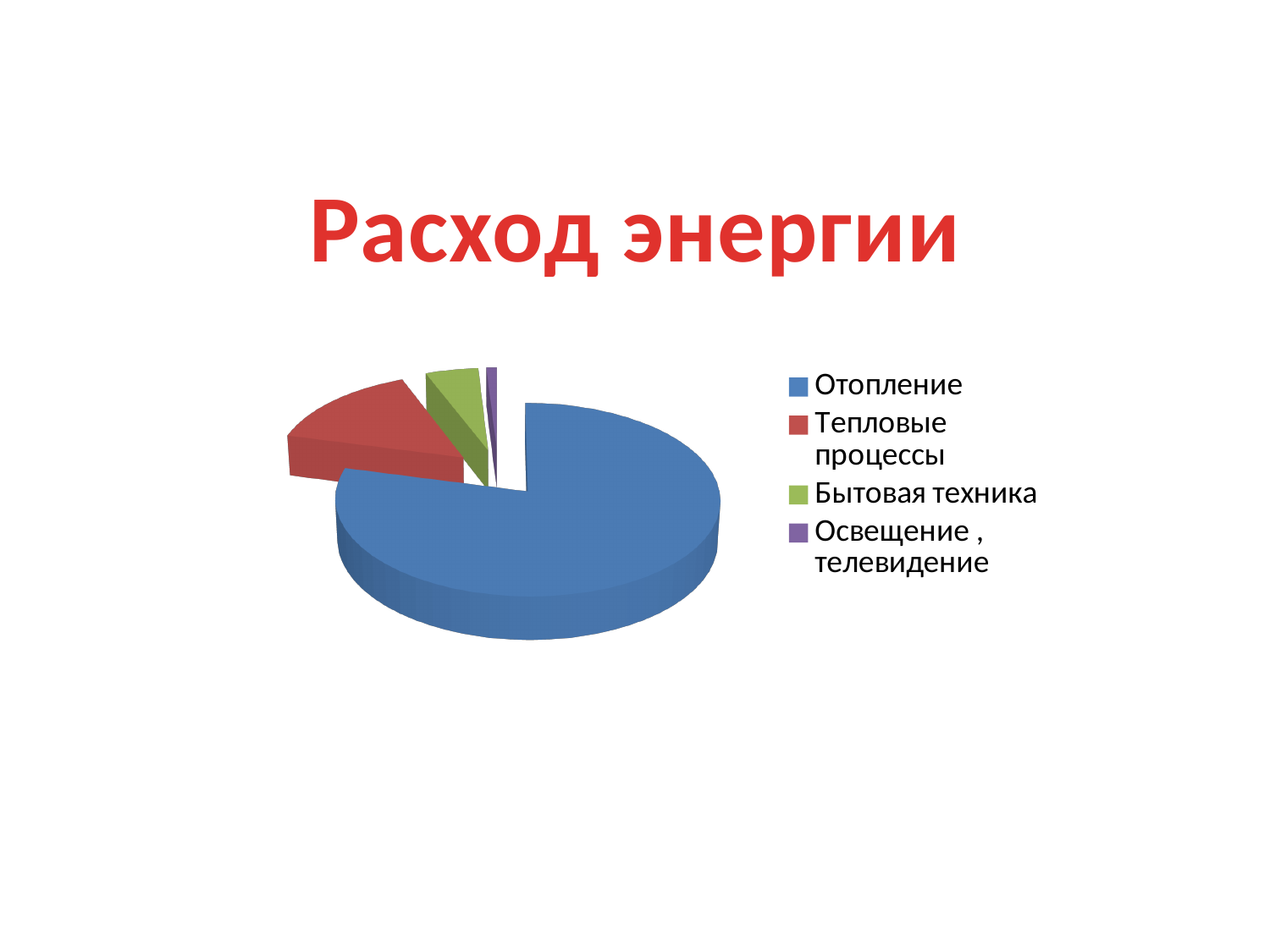
Which category is shown in blue? Отопление What kind of chart is shown on the slide? pie chart What is the title of the chart? Расход энергии Which category is the second largest slice of the pie? Тепловые процессы Which category has the largest slice of the pie? Отопление Which category has the smallest slice of the pie? Освещение , телевидение Which slice is larger, Отопление or Тепловые процессы? Отопление How many categories does the pie chart have? 4 Which slice is larger, Бытовая техника or Освещение , телевидение? Бытовая техника Which slice is larger, Тепловые процессы or Бытовая техника? Тепловые процессы